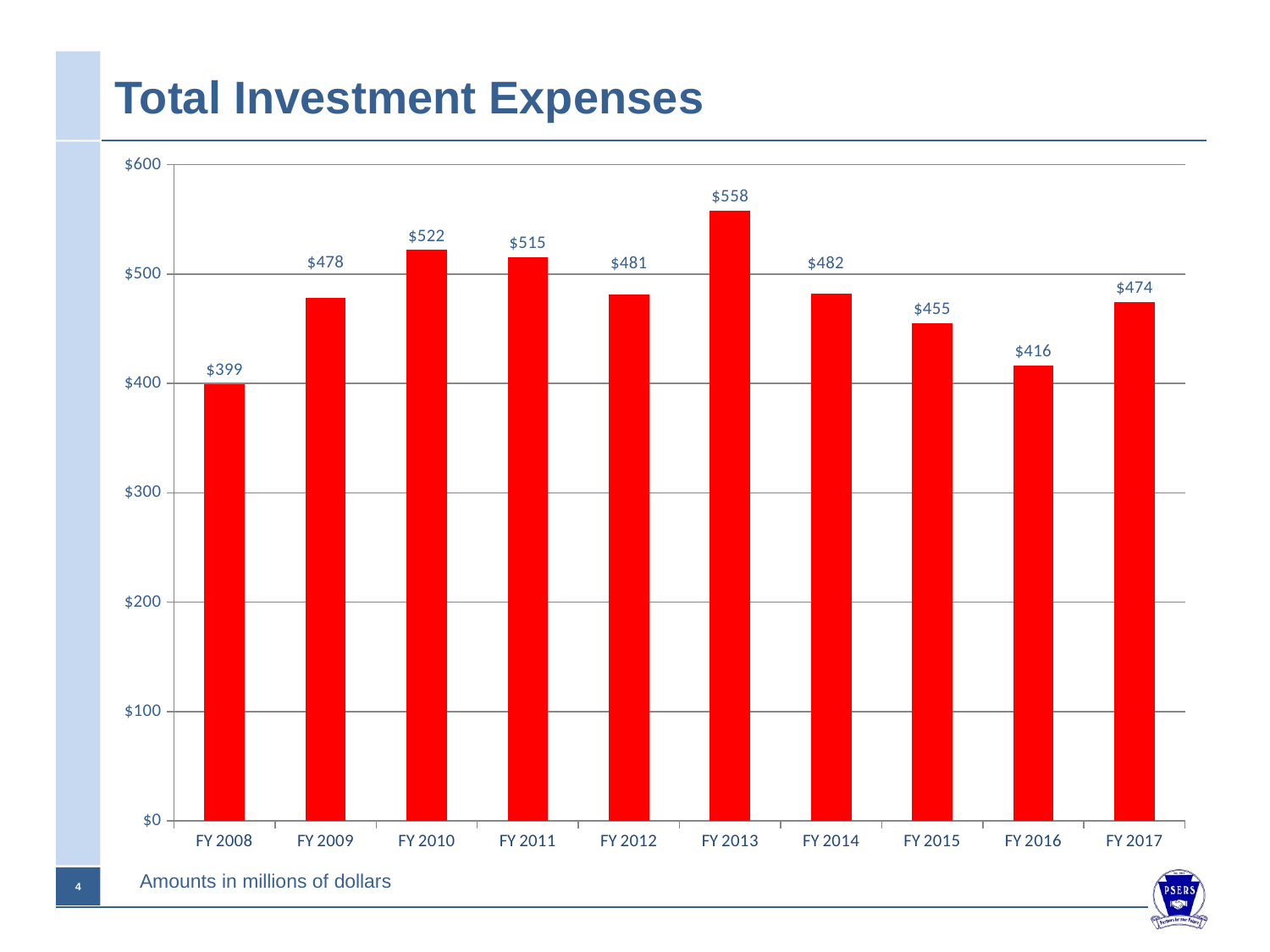
Which fiscal year has the lowest total investment expenses? FY 2008 What is the value for FY 2008? $399 What is the difference between the values for FY 2010 and FY 2011? $7 What is the difference between the values for FY 2013 and FY 2008? $159 Which fiscal year has the highest total investment expenses? FY 2013 What kind of chart is shown on the slide? bar chart What is the title of the chart? Total Investment Expenses Is the value for FY 2010 greater or less than $500? greater Which is larger, the value for FY 2015 or the value for FY 2016? FY 2015 How many fiscal years are shown on the chart? 10 What is the value for FY 2016? $416 What is the value for FY 2013? $558